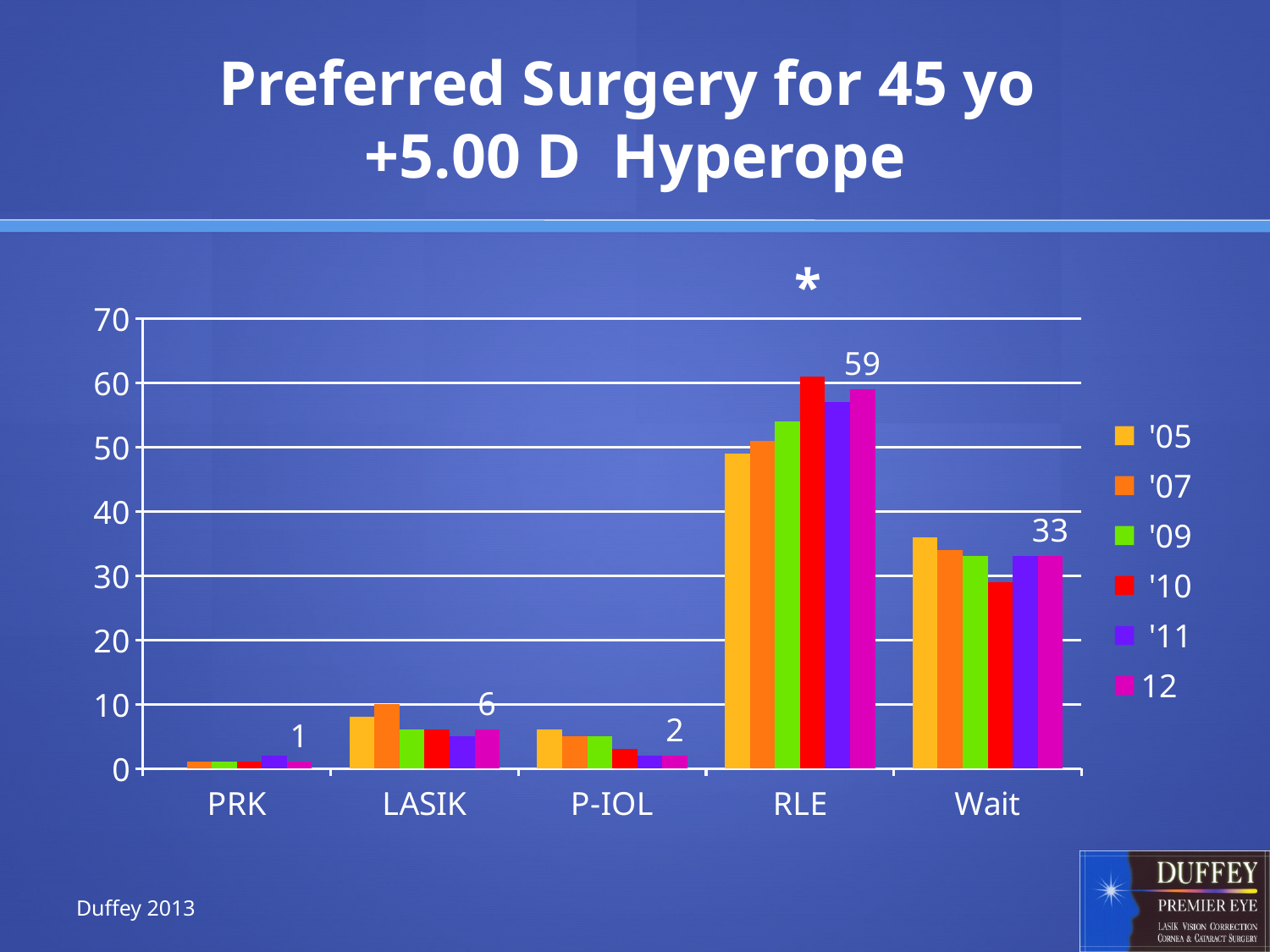
What is the value for the 12 series in the LASIK category? 6 How many series does the legend list? 6 Which category has the lowest value for the 12 series? PRK What is the value for the 12 series in the RLE category? 59 Is the value for the '05 series in the RLE category greater or less than 40? greater What kind of chart is shown on the slide? Bar chart What is the value for the 12 series in the Wait category? 33 How many categories are shown on the x axis? 5 What is the value for the 12 series in the PRK category? 1 Which category has the highest value for the 12 series? RLE For the 12 series, which is larger: P-IOL or LASIK? LASIK What is the difference between the 12 series values for RLE and Wait? 26